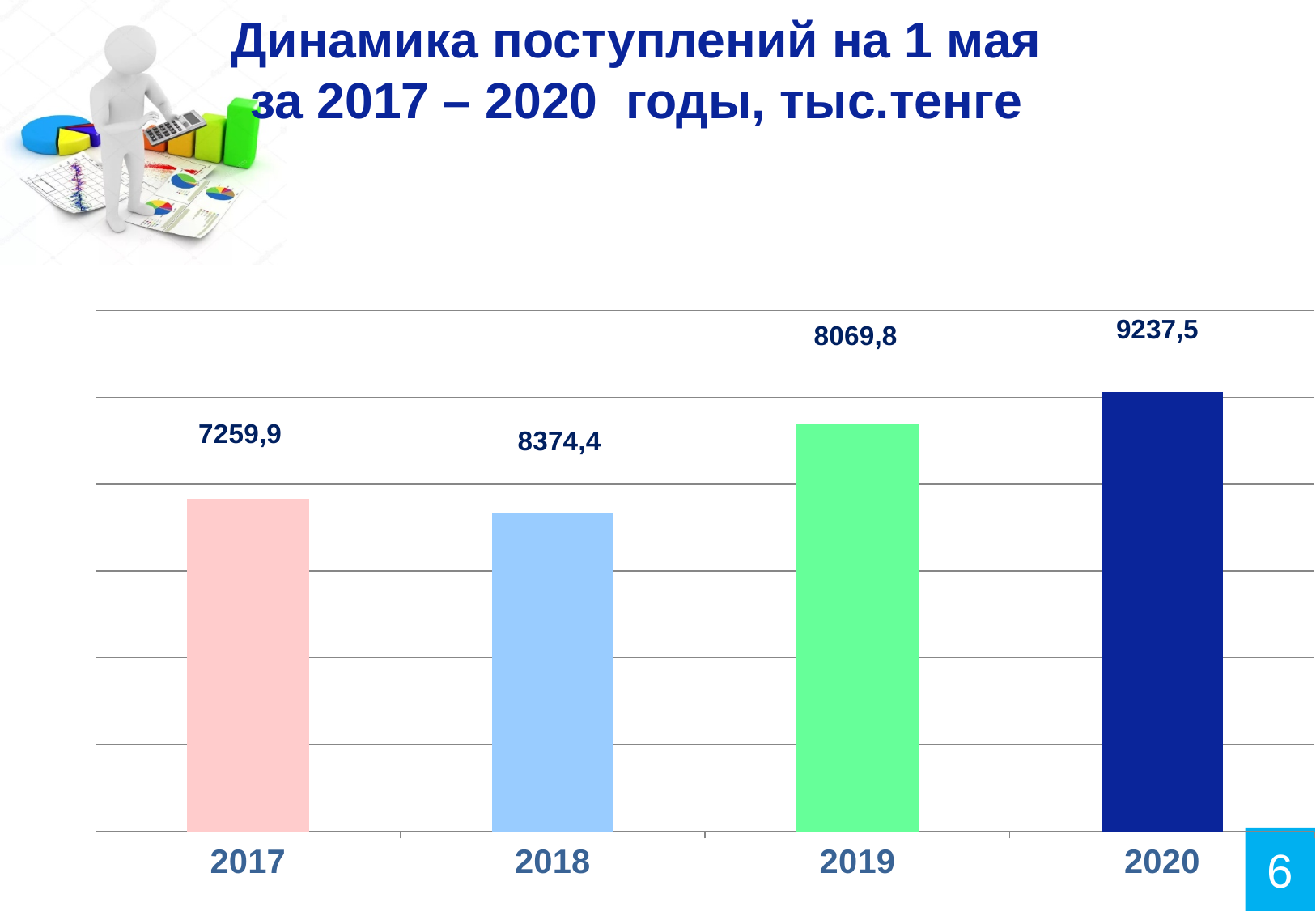
What unit of measurement is given in the chart title? тыс.тенге What is the difference between the values for 2020 and 2019? 1167,7 What is the difference between the values for 2020 and 2017? 1977,6 How many years are shown on the chart? 4 Which year has the highest value? 2020 What is the value for 2017? 7259,9 Which is larger, the value for 2019 or the value for 2017? 2019 What kind of chart is shown on the slide? Bar chart What is the value for 2018? 8374,4 What is the value for 2020? 9237,5 What is the value for 2019? 8069,8